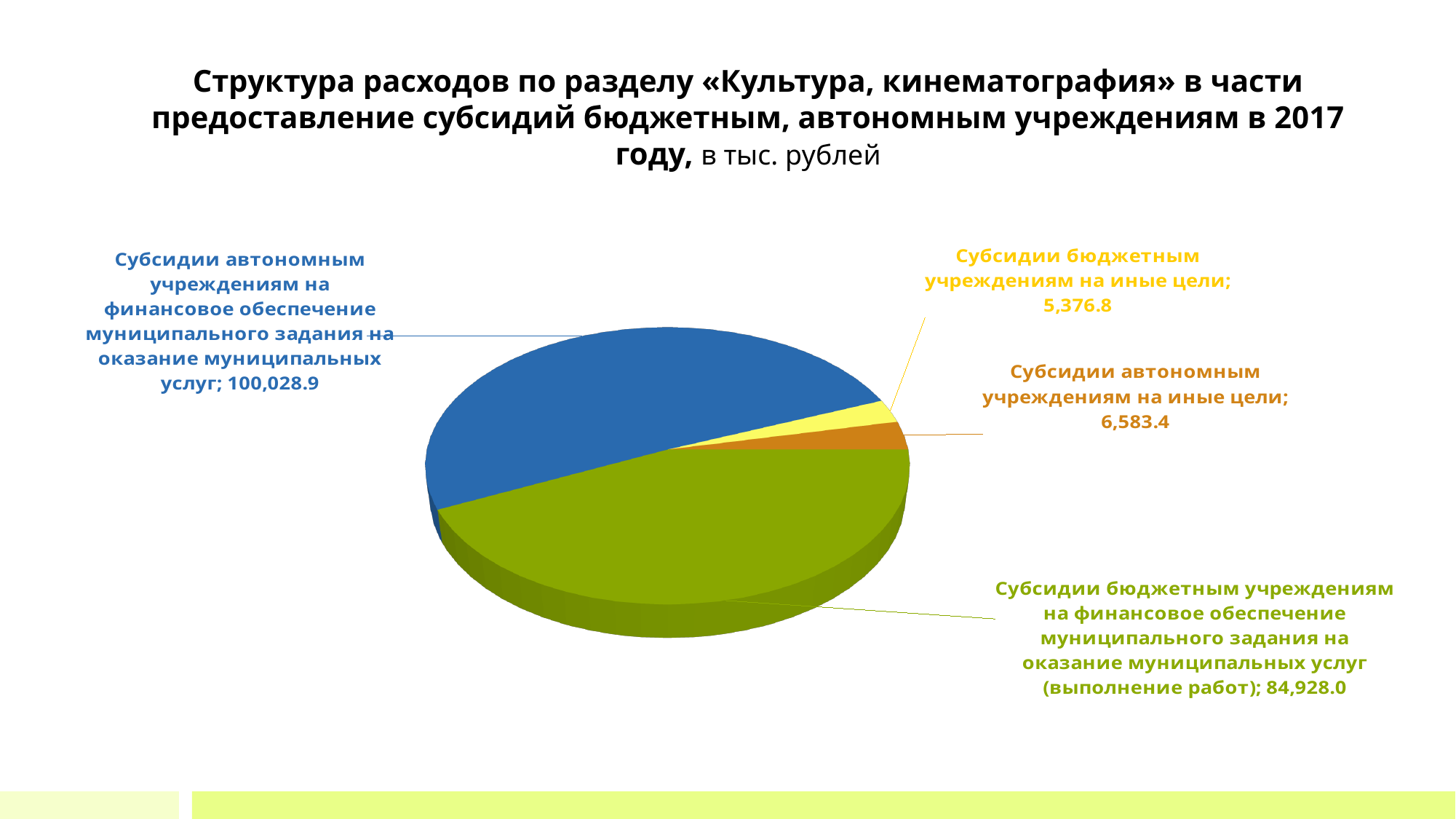
What is the value for "Субсидии бюджетным учреждениям на финансовое обеспечение муниципального задания на оказание муниципальных услуг (выполнение работ)"? 84,928.0 What is the value for "Субсидии автономным учреждениям на иные цели"? 6,583.4 What is the value for "Субсидии автономным учреждениям на финансовое обеспечение муниципального задания на оказание муниципальных услуг"? 100,028.9 What is the difference between the value for subsidies to autonomous institutions for the municipal task (100,028.9) and subsidies to budget institutions for the municipal task (84,928.0)? 15,100.9 How many slices does the pie chart have? 4 Which is larger: "Субсидии автономным учреждениям на иные цели" or "Субсидии бюджетным учреждениям на иные цели"? Субсидии автономным учреждениям на иные цели What is the value for "Субсидии бюджетным учреждениям на иные цели"? 5,376.8 In what unit are the values on the slide expressed, according to the title? тыс. рублей What is the total of all four values shown in the pie chart? 196,917.1 Which category has the smallest value in the pie chart? Субсидии бюджетным учреждениям на иные цели What type of chart is shown on the slide? Pie chart Which category has the largest value in the pie chart? Субсидии автономным учреждениям на финансовое обеспечение муниципального задания на оказание муниципальных услуг